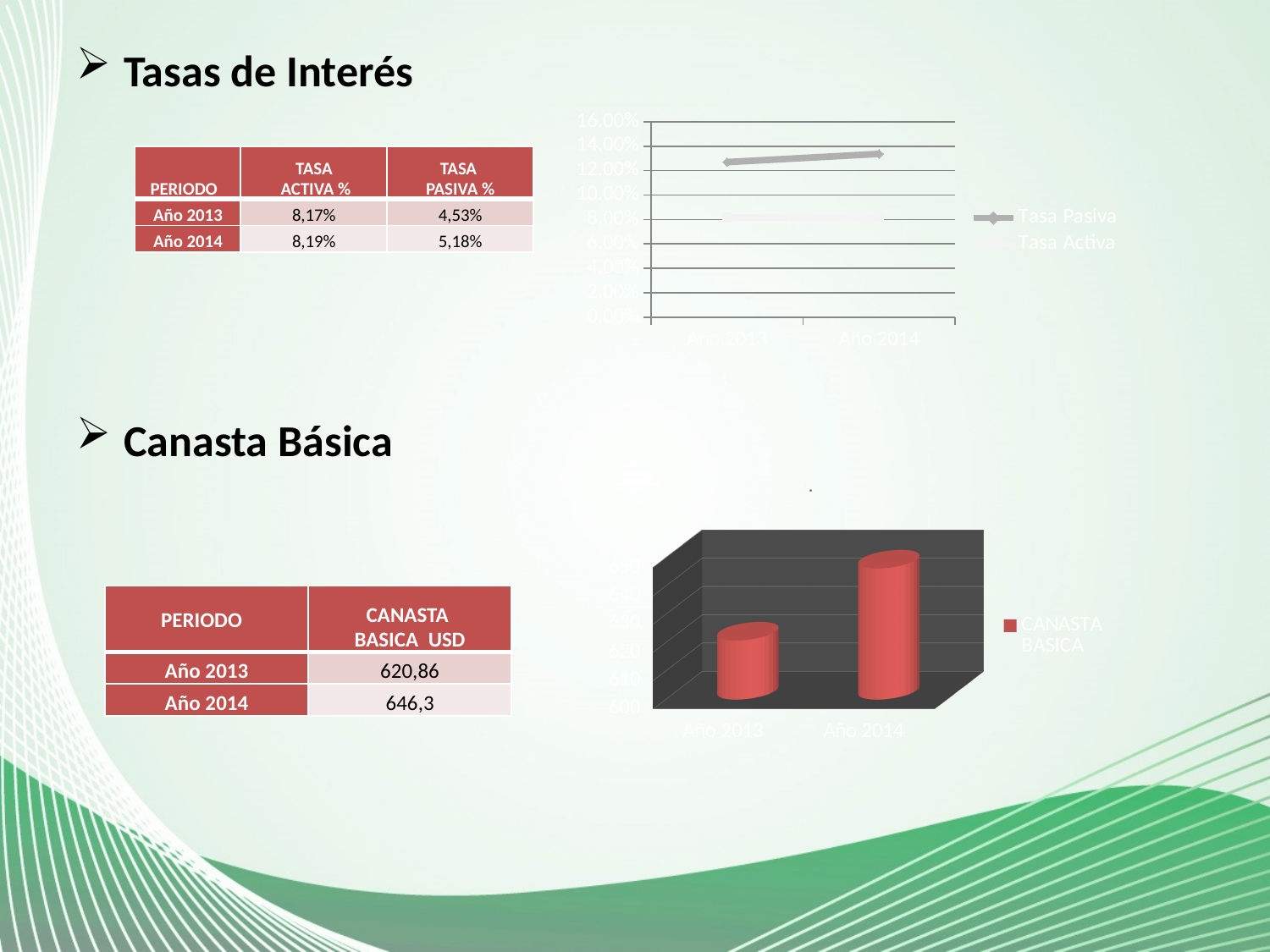
What is the name of the single series in the legend of the Canasta Básica bar chart? CANASTA BASICA In the Canasta Básica bar chart, which year has the lowest bar? Año 2013 In the Canasta Básica bar chart, which year has the highest bar? Año 2014 What kind of chart is the Tasas de Interés chart on the upper right of the slide? line chart According to the Canasta Básica table on the slide, what is the CANASTA BASICA USD value for Año 2013? 620,86 In the Canasta Básica bar chart, is the value for Año 2014 greater or less than 630? greater What kind of chart is the Canasta Básica chart on the lower right of the slide? bar chart According to the Canasta Básica table on the slide, what is the CANASTA BASICA USD value for Año 2014? 646,3 In the Canasta Básica bar chart, is the value for Año 2013 greater or less than 630? less In the Canasta Básica bar chart, do the values rise or fall from Año 2013 to Año 2014? rise How many series does the legend of the Tasas de Interés line chart list? 2 How many categories are shown on the x axis of the Canasta Básica bar chart? 2